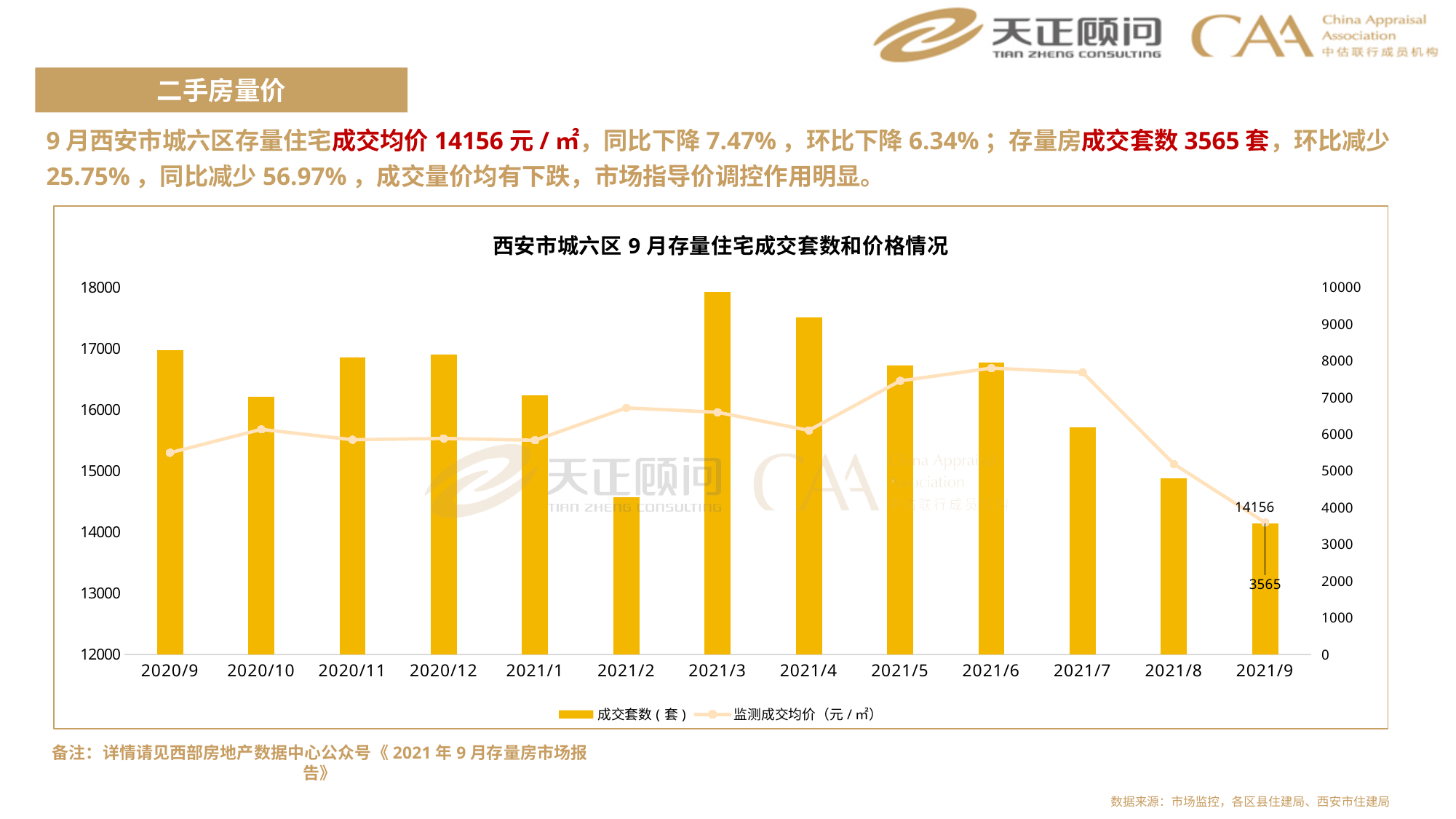
Which month has the larger 成交套数 (套) bar, 2020/9 or 2020/10? 2020/9 Which month has the lowest point on the 监测成交均价 (元/㎡) line? 2021/9 How many months are shown on the x axis? 13 Is the 监测成交均价 (元/㎡) point for 2021/8 greater or less than 16000 on the left axis? less Does the 监测成交均价 (元/㎡) line rise or fall from 2021/6 to 2021/9? fall Is the 成交套数 (套) bar for 2021/3 greater or less than 9000 on the right axis? greater Which month has the lowest 成交套数 (套) bar? 2021/9 Is the 成交套数 (套) bar for 2021/2 greater or less than 5000 on the right axis? less How many series does the legend list? 2 Which month has the highest 成交套数 (套) bar? 2021/3 What is the 成交套数 (套) value labelled for 2021/9? 3565 What is the 监测成交均价 (元/㎡) value labelled for 2021/9? 14156